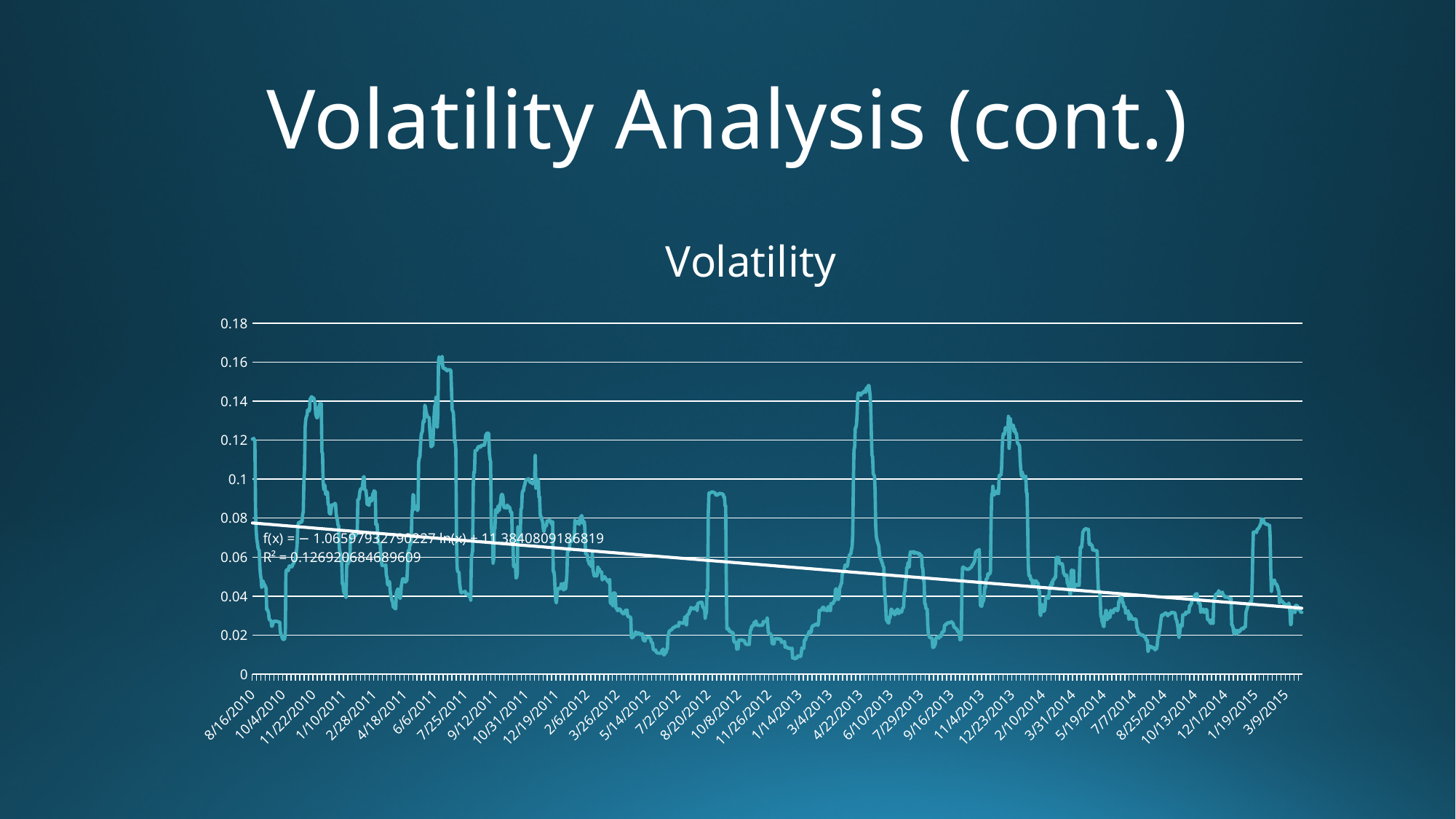
Is the lowest volatility value near 7/2/2012 greater or less than 0.02? less What kind of chart is shown on the slide? Line chart Is the peak volatility value near 6/6/2011 greater or less than 0.14? greater Is the peak near 6/6/2011 higher or lower than the peak near 4/22/2013? Higher According to the fitted trendline, do the volatility values generally rise or fall from 8/16/2010 to 3/9/2015? Fall What R² value is printed on the chart for the trendline? 0.126920684689609 Is the peak volatility value near 12/23/2013 greater or less than 0.12? greater What is the title of the chart? Volatility